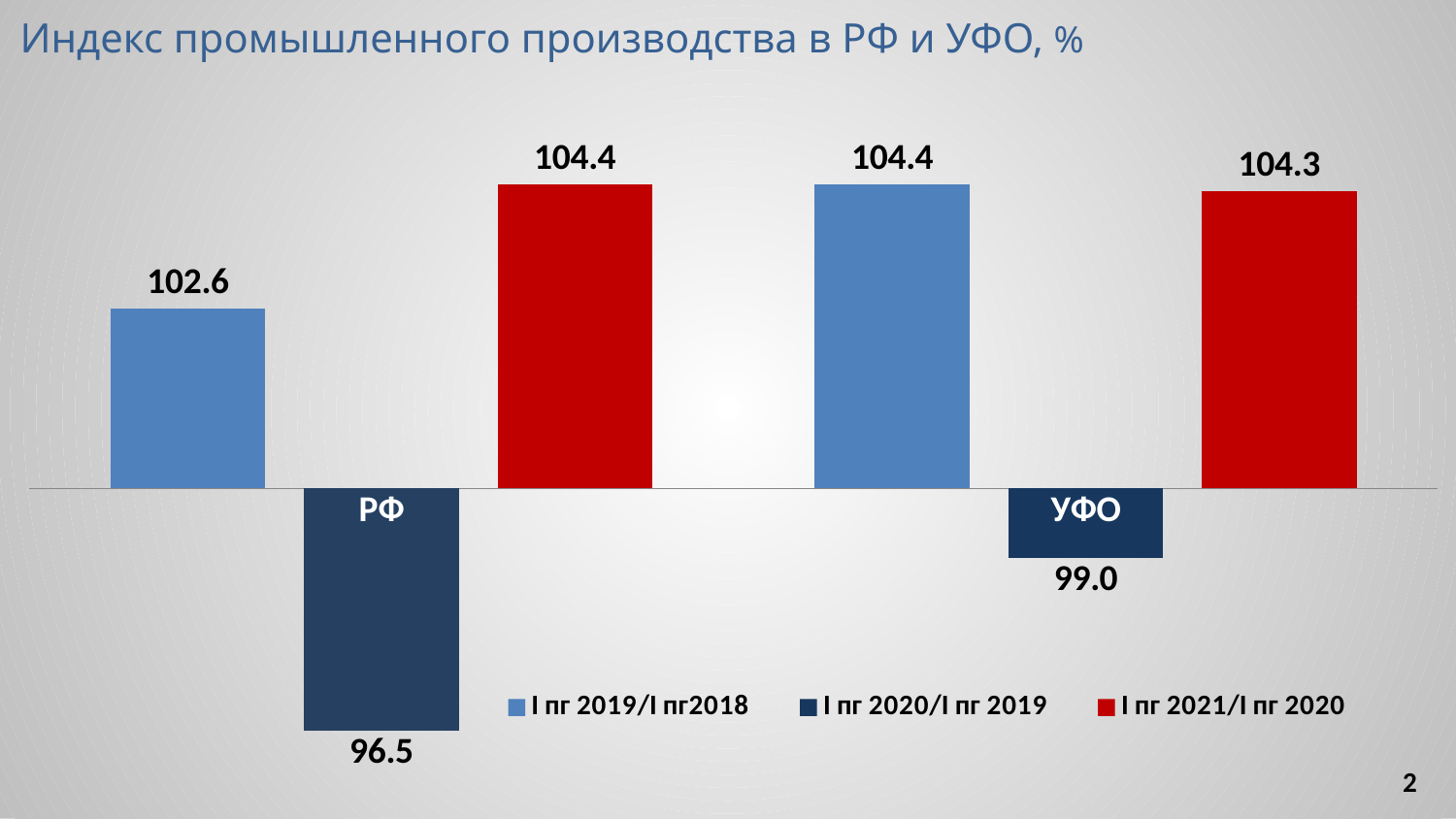
What is the value for УФО in the series I пг 2021/I пг 2020? 104.3 How many categories are shown on the x axis? 2 What is the difference between the I пг 2021/I пг 2020 value and the I пг 2020/I пг 2019 value for РФ? 7.9 What is the value for РФ in the series I пг 2020/I пг 2019? 96.5 What is the value for УФО in the series I пг 2020/I пг 2019? 99.0 Which is larger: the I пг 2020/I пг 2019 value for РФ or for УФО? УФО Which category has the lowest value in the series I пг 2020/I пг 2019? РФ Which category has the highest value in the series I пг 2019/I пг2018? УФО What type of chart is shown on the slide? Bar chart What is the value for РФ in the series I пг 2019/I пг2018? 102.6 What is the difference between the I пг 2019/I пг2018 values for УФО and РФ? 1.8 How many series does the legend list? 3